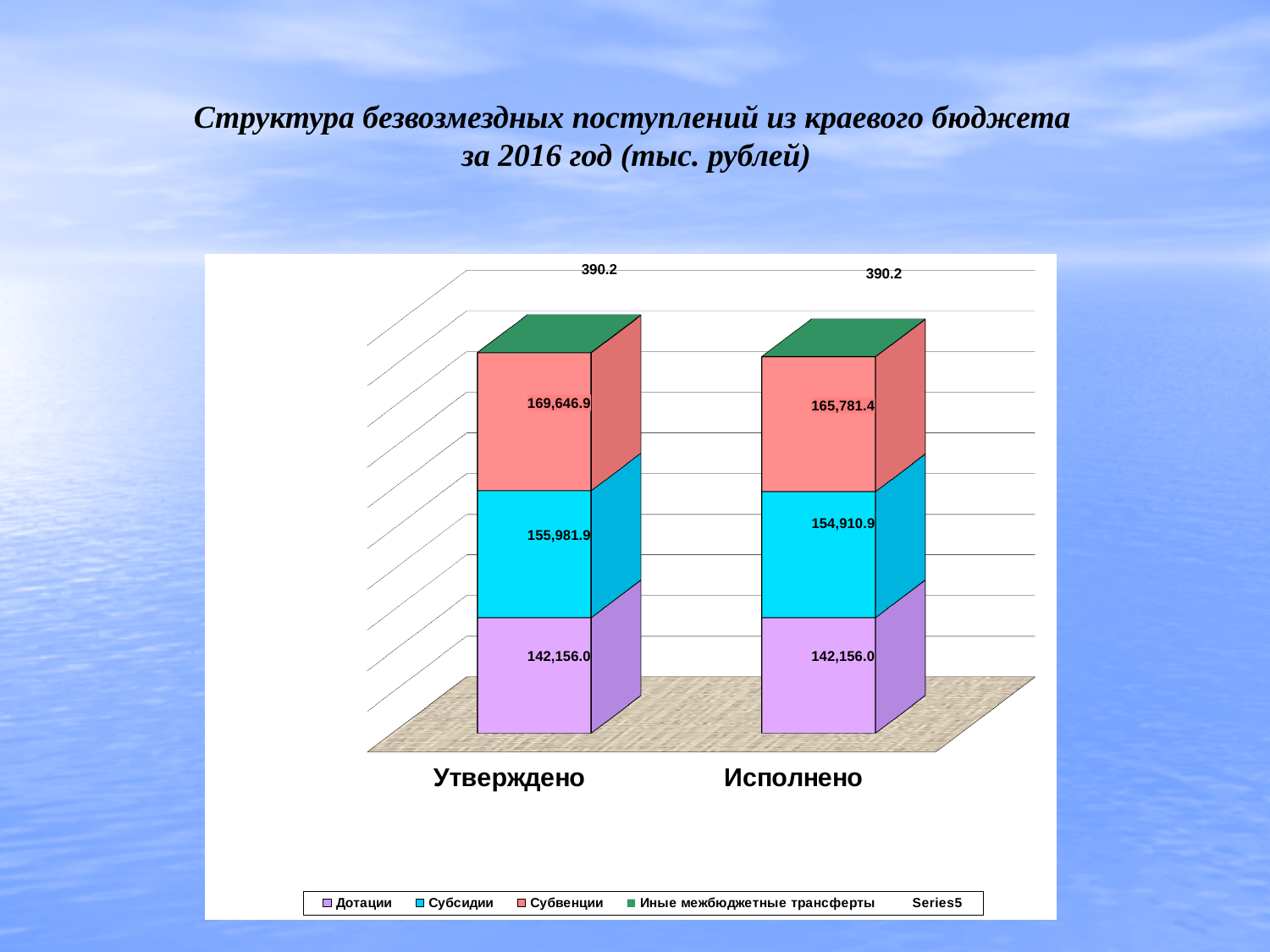
What is the total of the Исполнено stacked bar? 463,238.5 What is the value of Дотации for Исполнено? 142,156.0 Which series has the largest value in the Утверждено bar? Субвенции What is the difference between the Субсидии values for Утверждено and Исполнено? 1,071.0 Which series has the smallest value in the Исполнено bar? Иные межбюджетные трансферты What is the value of Иные межбюджетные трансферты for Утверждено? 390.2 What is the value of Субвенции for Утверждено? 169,646.9 How many categories are shown on the x axis? 2 What is the difference between the Субвенции values for Утверждено and Исполнено? 3,865.5 Is the Субсидии value larger for Утверждено or for Исполнено? Утверждено What kind of chart is shown on the slide? Stacked bar chart What is the value of Субсидии for Исполнено? 154,910.9